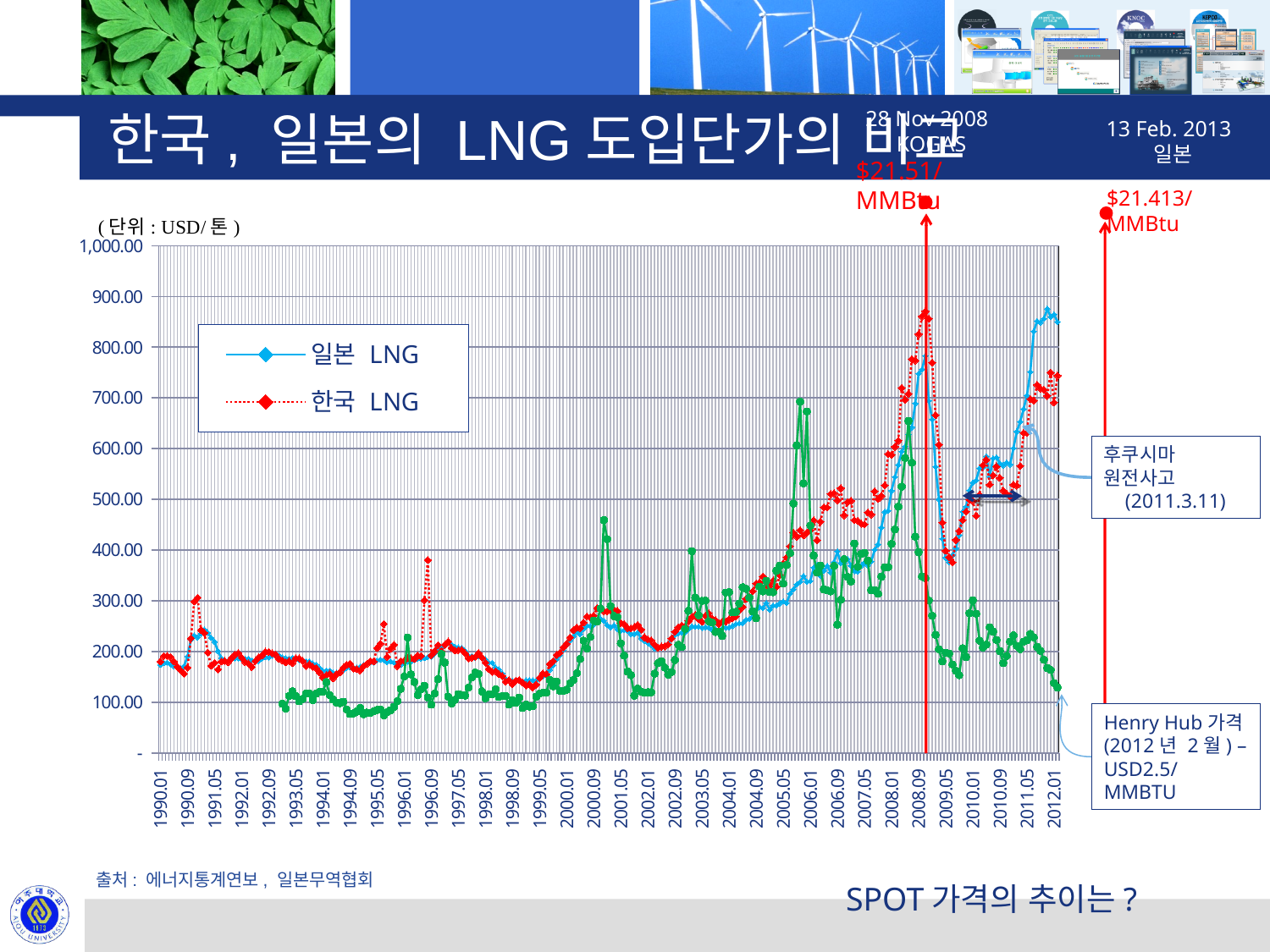
Is the value for 한국 LNG at 1990.01 greater or less than 300.00? less Does the 한국 LNG series rise or fall between 2005.05 and 2008.09? rise Is the value for 일본 LNG at 2000.09 greater or less than 400.00? less Does the 한국 LNG series rise or fall between 2008.09 and 2009.05? fall Is the value for 한국 LNG around 2008.09 greater or less than 800.00? greater What unit is given for the values in the chart? USD/톤 How many series does the chart legend list? 2 What kind of chart is shown on the slide? line chart Does the 일본 LNG series rise or fall between 2009.05 and 2011.09? rise What colour is the 일본 LNG series in the legend? blue